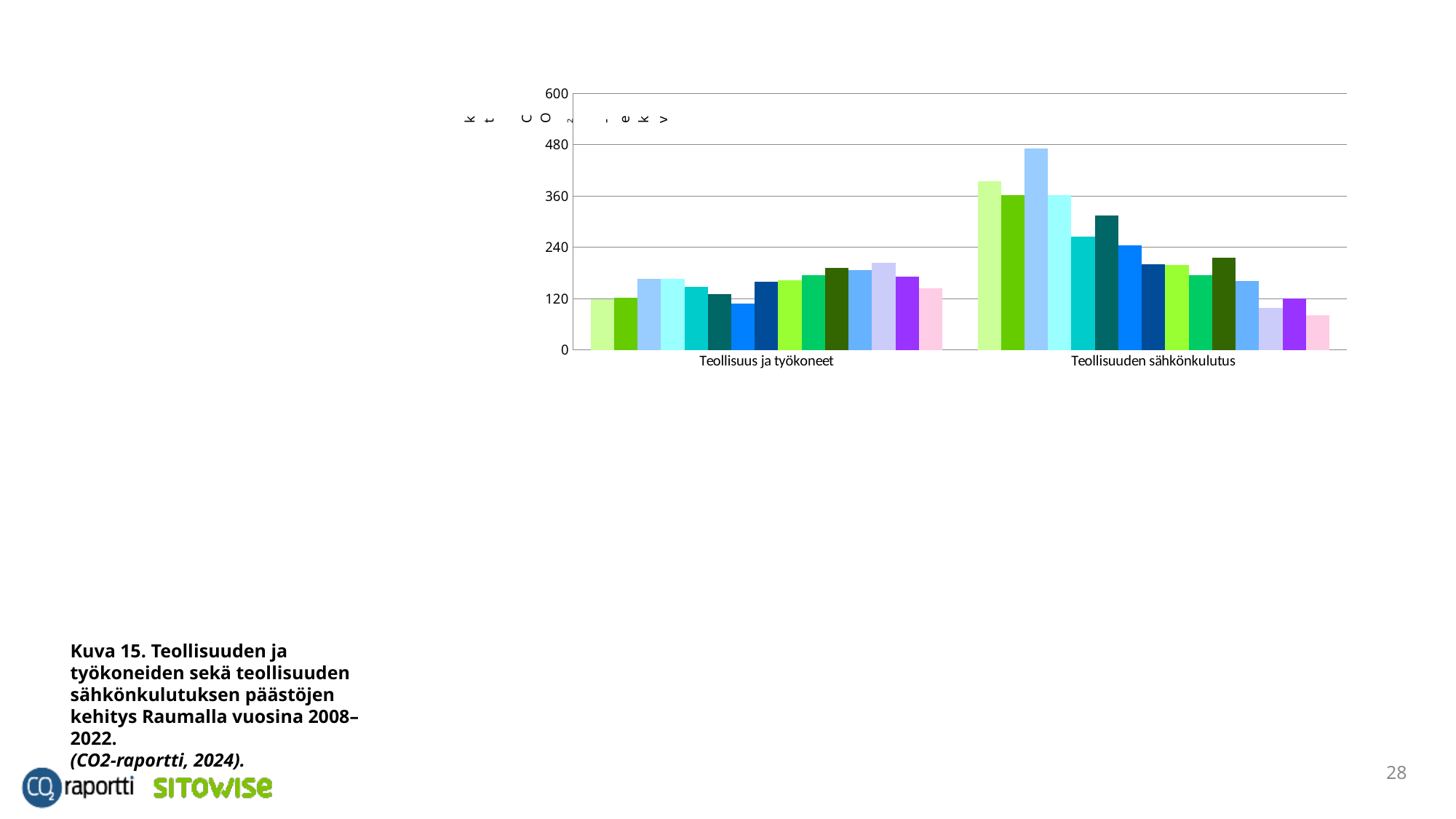
Is the first (leftmost) bar in the Teollisuuden sähkönkulutus group greater or less than 360? greater Is the last (rightmost) bar in the Teollisuuden sähkönkulutus group greater or less than 120? less What is the highest value shown on the y axis? 600 How many categories are shown on the x axis of the chart? 2 What kind of chart is shown on the slide? Bar chart Which category contains the tallest bar in the chart? Teollisuuden sähkönkulutus What are the two category labels on the x axis? Teollisuus ja työkoneet; Teollisuuden sähkönkulutus Is the tallest bar in the Teollisuuden sähkönkulutus group greater or less than 360? greater Do the bars in the Teollisuuden sähkönkulutus group generally rise or fall from left to right? fall Which group has the larger first (leftmost) bar, Teollisuus ja työkoneet or Teollisuuden sähkönkulutus? Teollisuuden sähkönkulutus How many bars are plotted in the Teollisuuden sähkönkulutus group? 15